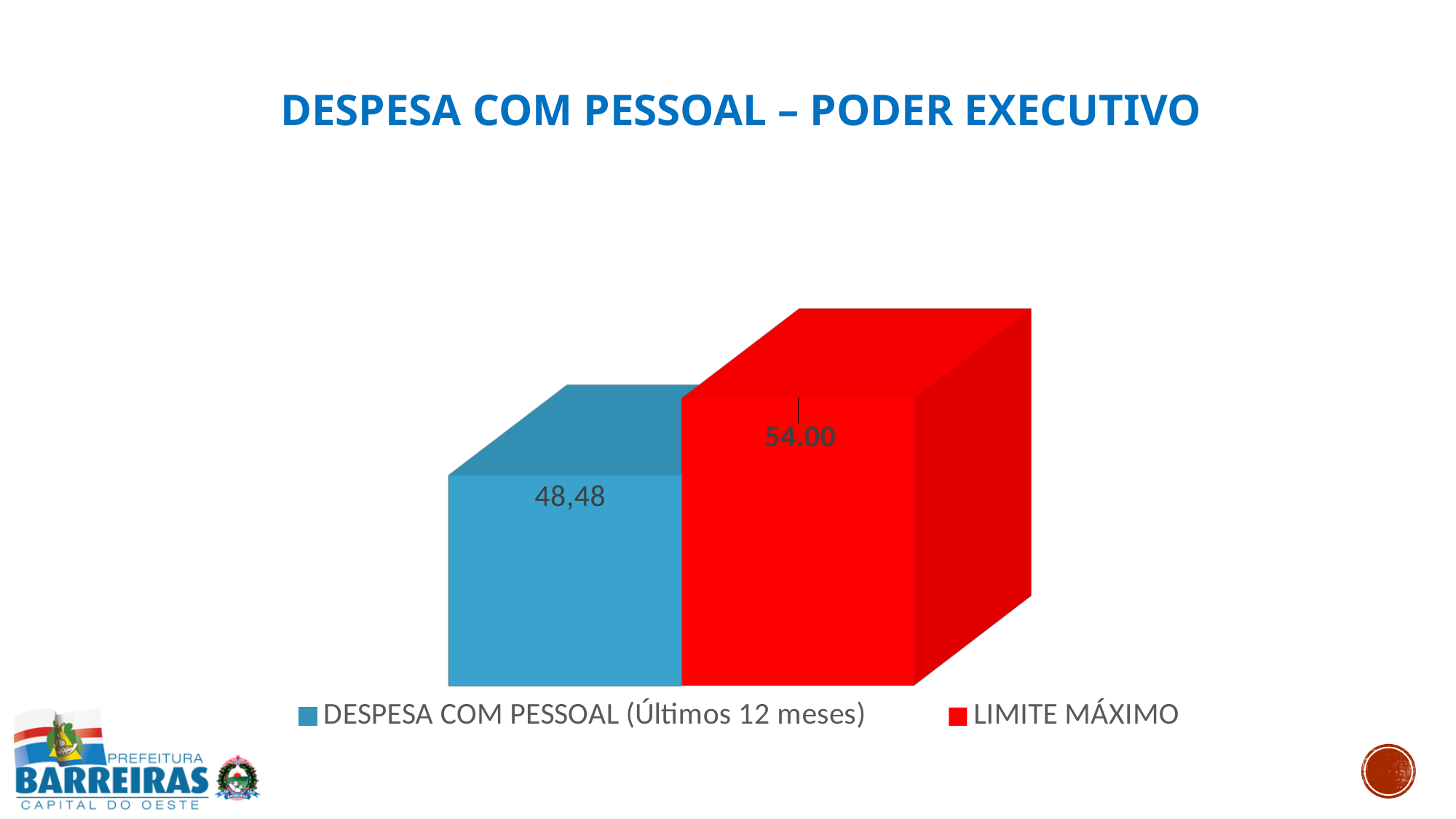
What is the value shown for LIMITE MÁXIMO? 54.00 How many bars are plotted in the chart? 2 Which bar is the shortest in the chart? DESPESA COM PESSOAL (Últimos 12 meses) Which series has the higher value, DESPESA COM PESSOAL (Últimos 12 meses) or LIMITE MÁXIMO? LIMITE MÁXIMO What is the value shown for DESPESA COM PESSOAL (Últimos 12 meses)? 48,48 Which bar is the tallest in the chart? LIMITE MÁXIMO What kind of chart is shown on the slide? Bar chart What is the difference between the LIMITE MÁXIMO value and the DESPESA COM PESSOAL (Últimos 12 meses) value? 5,52 What colour is the bar for LIMITE MÁXIMO? Red How many series does the legend list? 2 What is the title of the chart? DESPESA COM PESSOAL – PODER EXECUTIVO